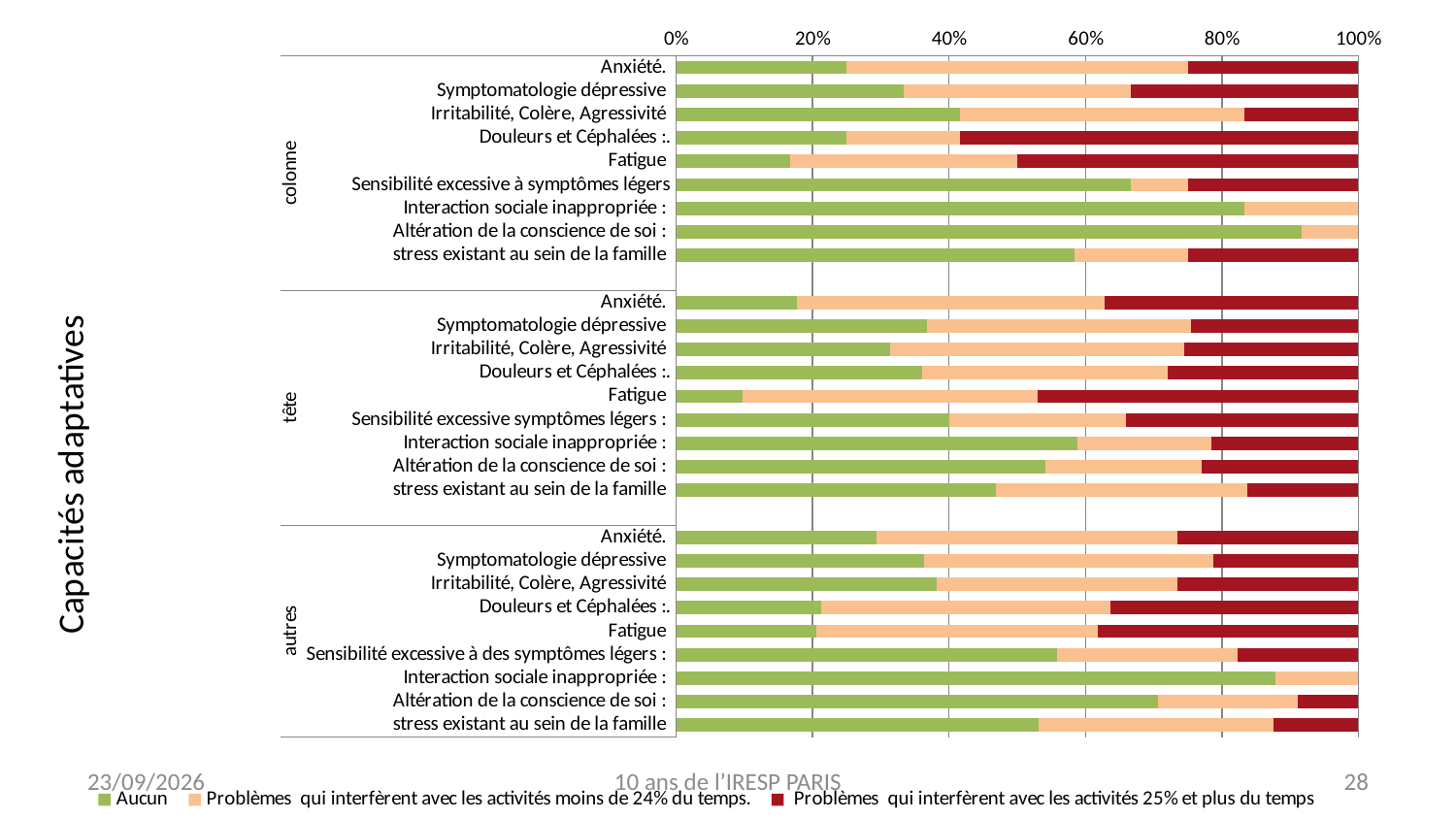
In the "tête" group, which category has the smallest "Aucun" share? Fatigue How many series does the legend list? 3 What kind of chart is shown on the slide? Stacked bar chart In the "autres" group, which category has the largest "Aucun" share? Interaction sociale inappropriée How many categories are plotted in the "tête" group? 9 In the "tête" group, is the "Aucun" share for "Fatigue" greater or less than 20%? less In the "colonne" group, which has the larger "Aucun" share: "Symptomatologie dépressive" or "Irritabilité, Colère, Agressivité"? Irritabilité, Colère, Agressivité What is the title written vertically to the left of the chart? Capacités adaptatives In the "colonne" group, is the "Aucun" share for "Interaction sociale inappropriée" greater or less than 80%? greater In the "colonne" group, is the "Aucun" share for "Fatigue" greater or less than 20%? less How many groups (colonne, tête, autres) are shown on the vertical axis? 3 In the "colonne" group, which category has the largest "Aucun" share? Altération de la conscience de soi